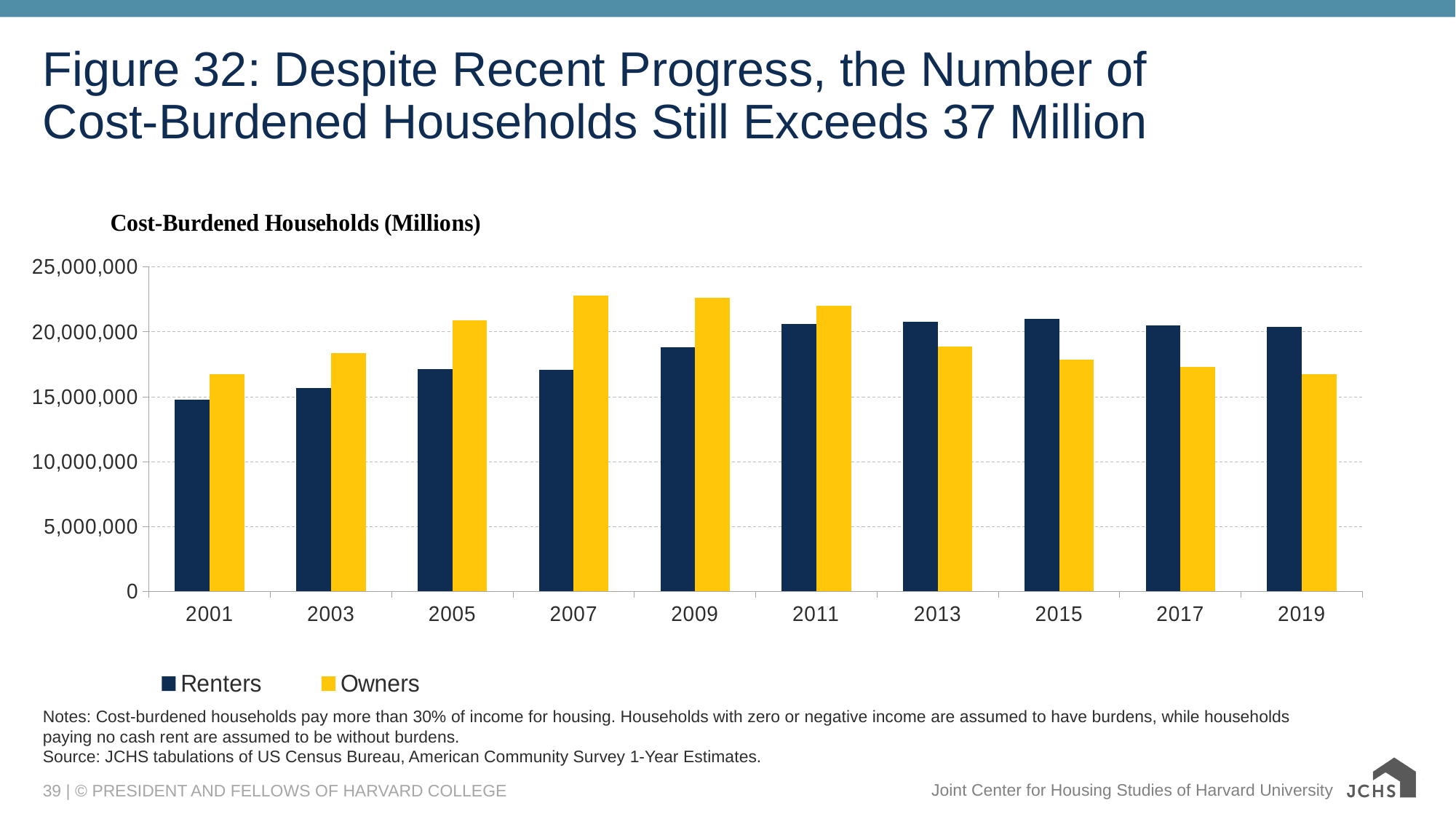
In 2019, which is larger, Renters or Owners? Renters What colour are the Owners bars? Yellow How many series does the legend list? 2 Do the Owners values rise or fall from 2007 to 2019? Fall Which year has the lowest value for Renters? 2001 How many years are shown on the x axis? 10 Is the value for Owners in 2007 greater or less than 20,000,000? greater Is the value for Renters in 2009 greater or less than 20,000,000? less What kind of chart is shown on the slide? Bar chart In 2001, which is larger, Renters or Owners? Owners Is the value for Owners in 2019 greater or less than 20,000,000? less